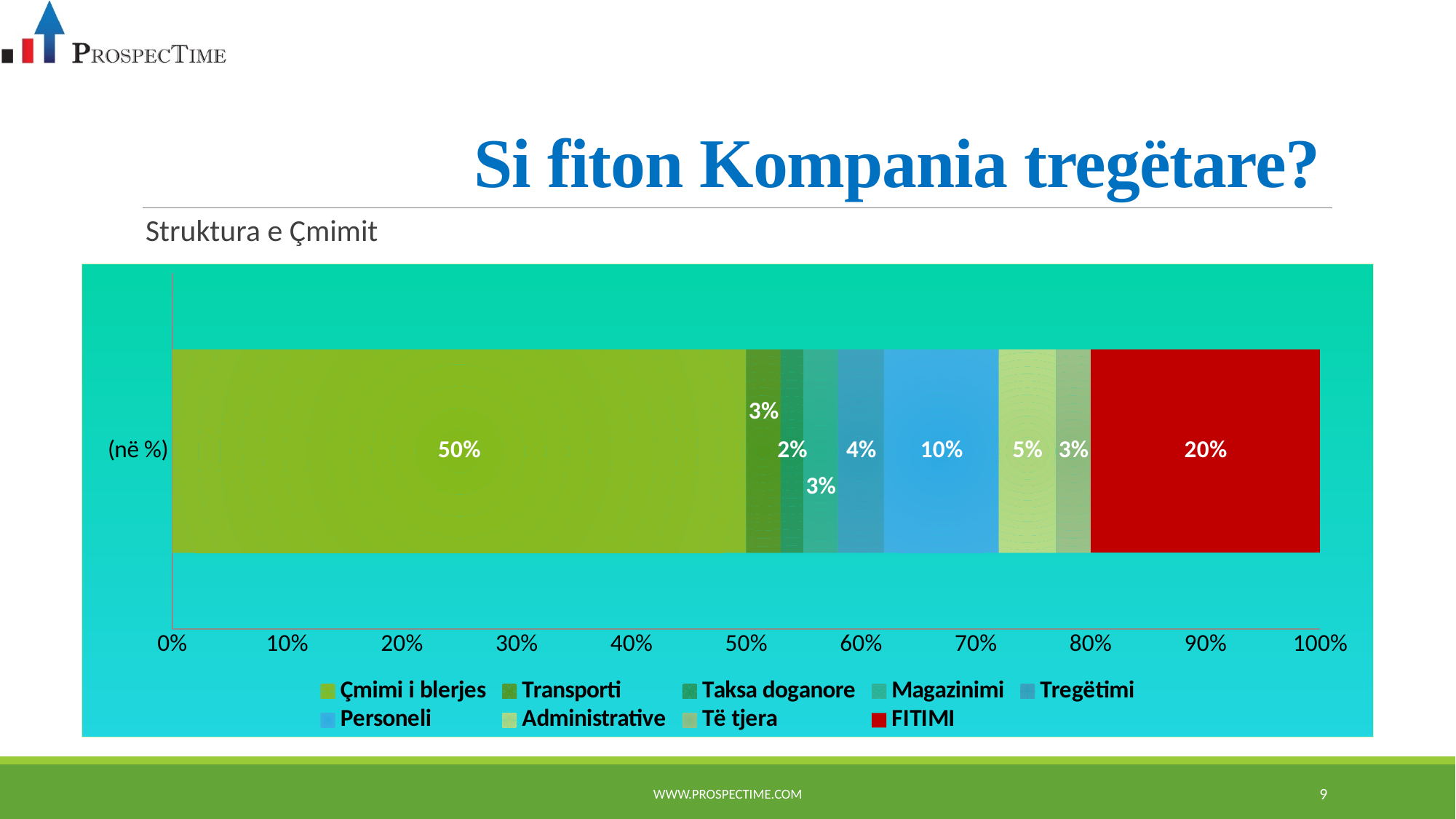
How many series does the legend list? 9 What is the difference between the values for Çmimi i blerjes and FITIMI? 30% Which series has the largest share of the bar? Çmimi i blerjes What is the value for FITIMI? 20% Which is larger, the value for Personeli or the value for Administrative? Personeli Which series has the smallest share of the bar? Taksa doganore What is the value for Çmimi i blerjes? 50% What type of chart is shown on the slide? Stacked bar chart What is the value for Tregëtimi? 4% What is the value for Personeli? 10% What is the value for Administrative? 5% What is the total of the stacked bar? 100%